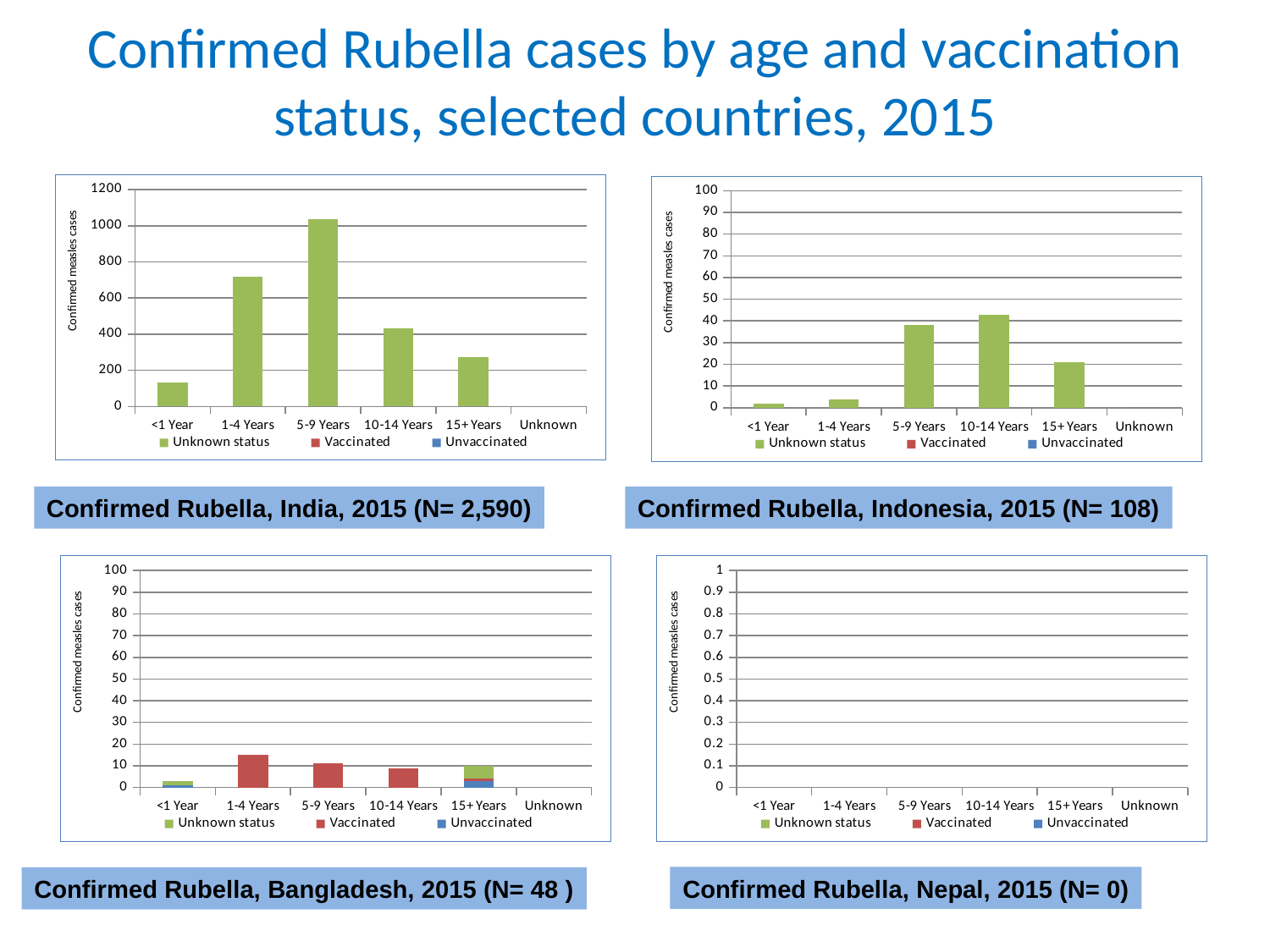
In the Confirmed Rubella, Bangladesh, 2015 chart, which age group has the tallest bar? 1-4 Years In the Confirmed Rubella, Indonesia, 2015 chart, which is larger, the value for 5-9 Years or the value for 1-4 Years? 5-9 Years How many series does the legend list in the Confirmed Rubella, Bangladesh, 2015 chart? 3 How many age categories are shown on the x axis of the Confirmed Rubella, Nepal, 2015 chart? 6 In the Confirmed Rubella, India, 2015 chart, which is larger, the value for 15+ Years or the value for <1 Year? 15+ Years In the Confirmed Rubella, Bangladesh, 2015 chart, is the total for 1-4 Years greater or less than 10? greater In the Confirmed Rubella, India, 2015 chart, which age group has the highest number of cases? 5-9 Years In the Confirmed Rubella, India, 2015 chart, is the value for 1-4 Years greater or less than 600? greater In the Confirmed Rubella, India, 2015 chart, is the value for 10-14 Years greater or less than 600? less What kind of chart is the Confirmed Rubella, India, 2015 chart? Bar chart